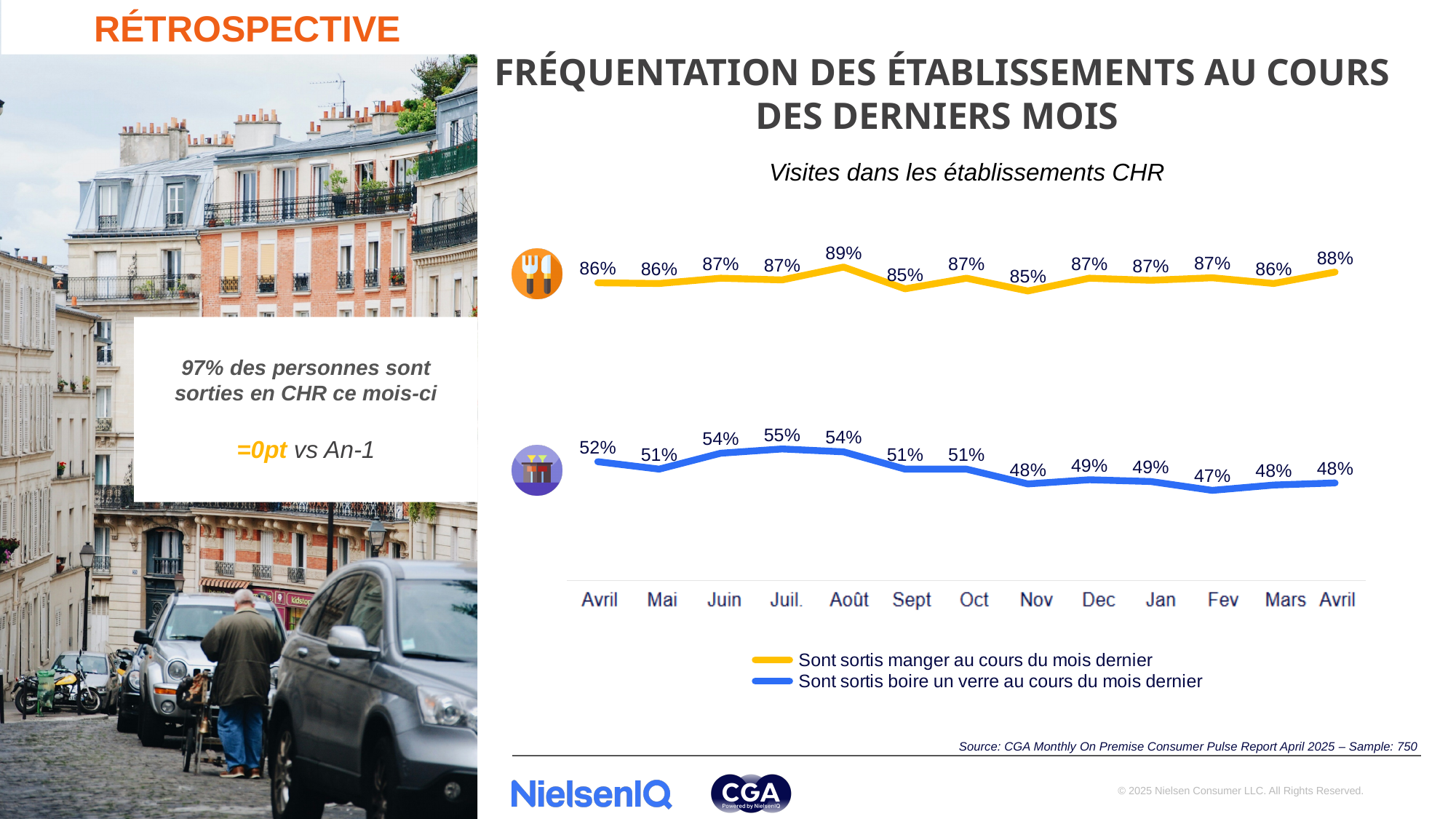
In which month is 'Sont sortis manger au cours du mois dernier' at its highest? Août What is the difference between the two series in the last Avril (rightmost point)? 40 points For 'Sont sortis boire un verre au cours du mois dernier', what is the difference between the first Avril and the last Avril? 4 points What is the value for 'Sont sortis boire un verre au cours du mois dernier' in Juil.? 55% Which series has the higher value in Sept: 'Sont sortis manger' or 'Sont sortis boire un verre'? Sont sortis manger au cours du mois dernier How many series does the legend list? 2 What is the value for 'Sont sortis boire un verre au cours du mois dernier' in Fev? 47% How many months are plotted along the x axis? 13 Does 'Sont sortis boire un verre au cours du mois dernier' generally rise or fall from Juil. to Fev? fall In which month is 'Sont sortis boire un verre au cours du mois dernier' at its lowest? Fev What kind of chart is shown on the slide? line chart What is the value for 'Sont sortis manger au cours du mois dernier' in Août? 89%